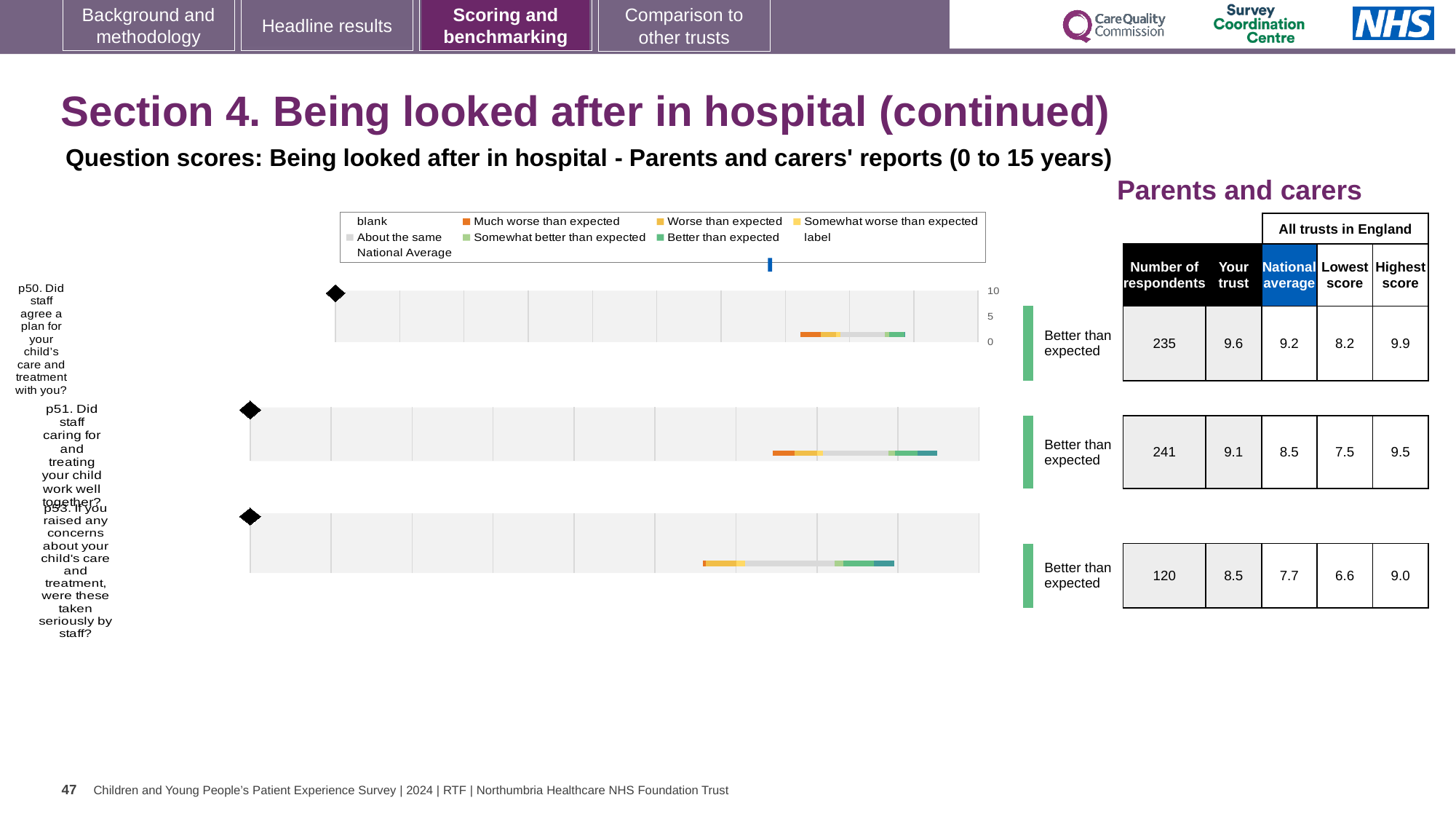
How many respondents answered p53 (If you raised any concerns about your child's care and treatment, were these taken seriously by staff)? 120 What is the highest score among all trusts in England for p51? 9.5 What is the 'Your trust' score for p50 (Did staff agree a plan for your child's care and treatment with you)? 9.6 For p50, what is the difference between the 'Your trust' score and the national average? 0.4 What benchmark category is shown for p53? Better than expected For p51, which is larger: the 'Your trust' score or the national average? Your trust Which question has the highest 'Your trust' score? p50 For p53, what is the difference between the highest score and the lowest score among all trusts in England? 2.4 How many questions (p50, p51, p53) are plotted on the slide? 3 Which question has the lowest national average score? p53 What kind of chart is used to show the question scores on this slide? bar chart What is the national average score for p51 (Did staff caring for and treating your child work well together)? 8.5